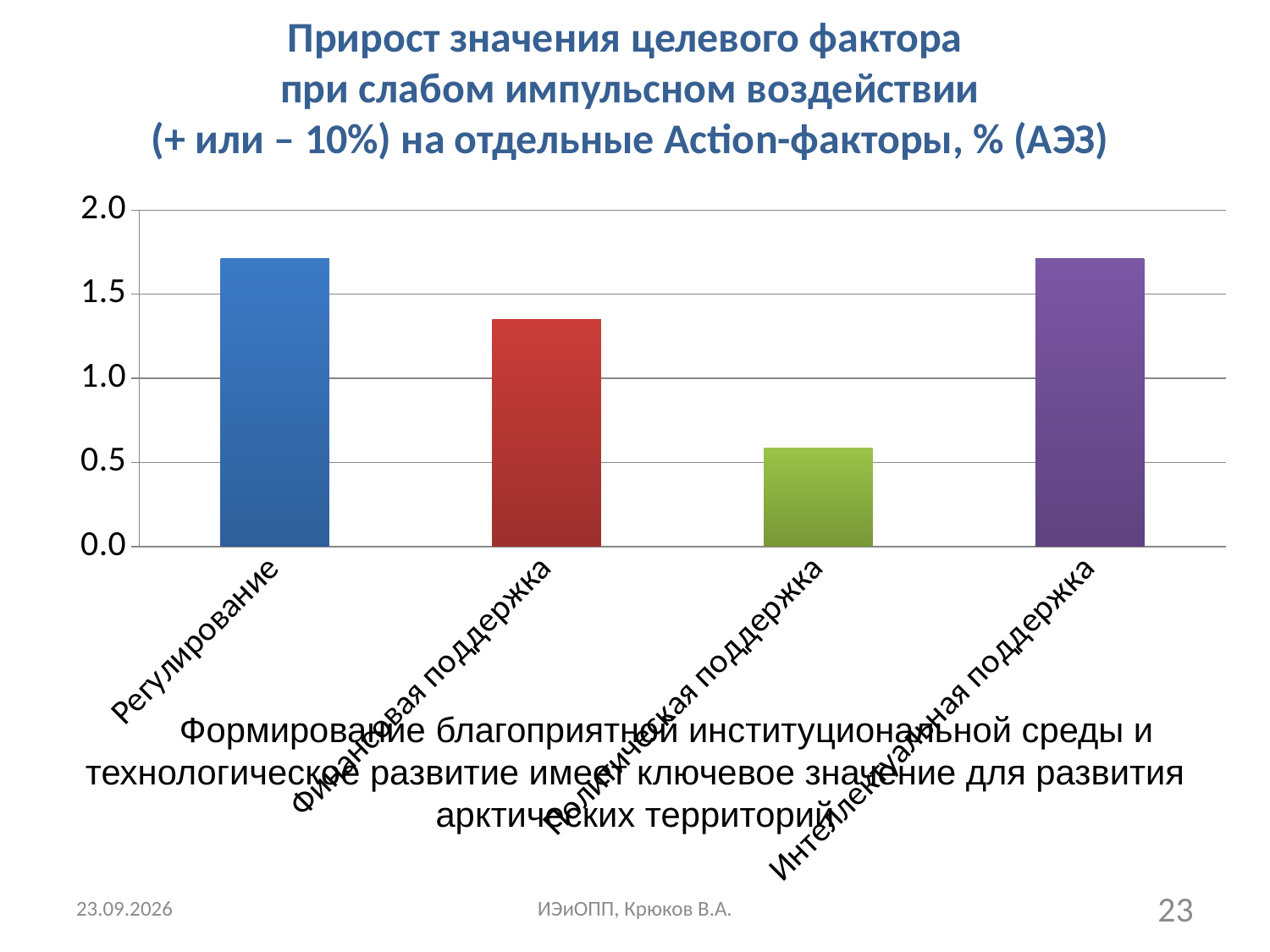
Is the value for Интеллектуальная поддержка greater or less than 1.5? greater What is the highest value shown on the vertical axis of the chart? 2.0 Is the value for Финансовая поддержка greater or less than 1.5? less Which is larger, the value for Финансовая поддержка or the value for Политическая поддержка? Финансовая поддержка Which category has the lowest value in the chart? Политическая поддержка How many categories are plotted in the chart? 4 Is the value for Политическая поддержка greater or less than 1.0? less What kind of chart is shown on the slide? bar chart Which is larger, the value for Регулирование or the value for Финансовая поддержка? Регулирование What colour is the bar for Политическая поддержка? green